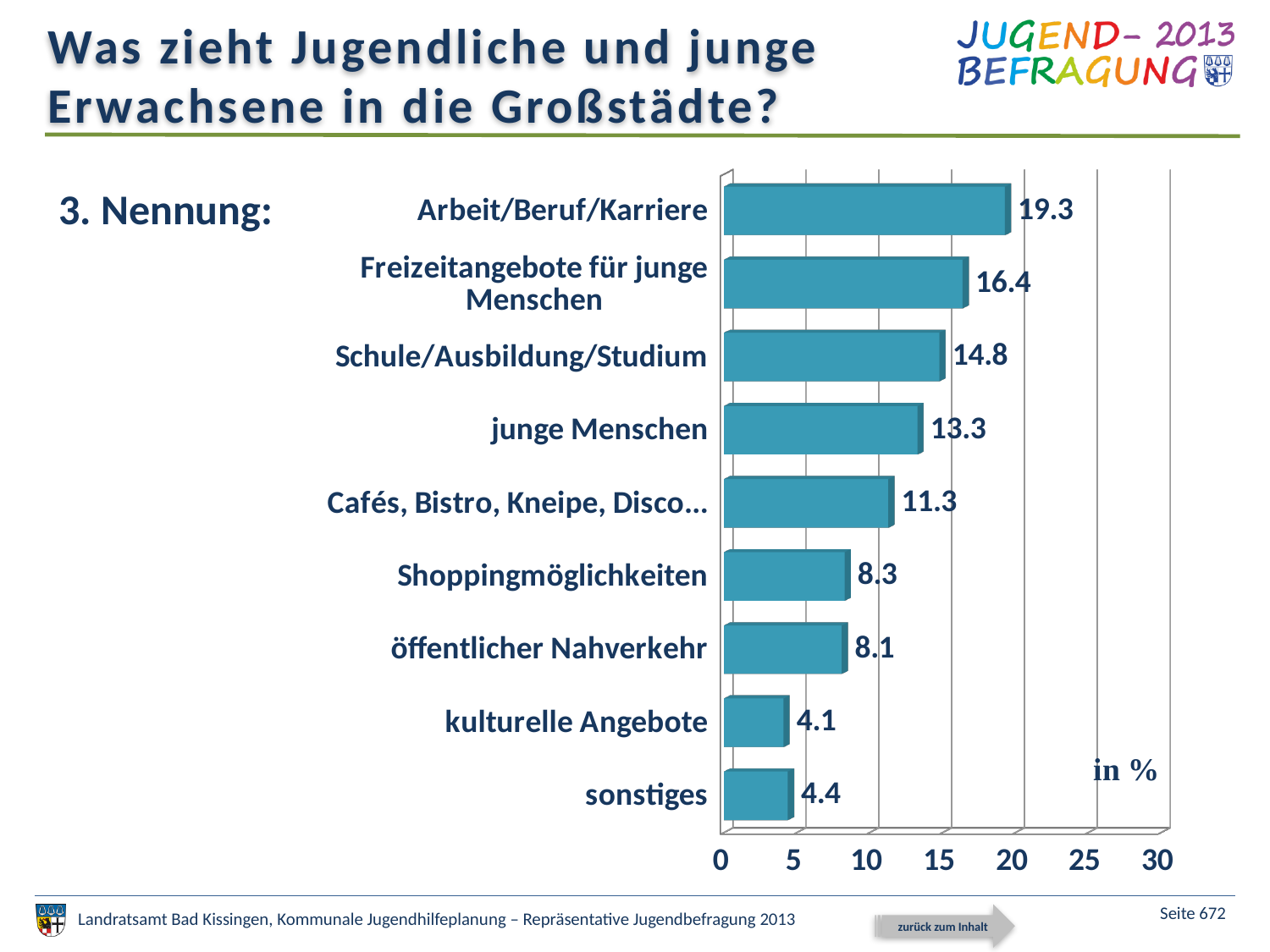
Which category has the highest value? Arbeit/Beruf/Karriere Is the value for junge Menschen greater or less than 10? greater Which is larger, the value for Shoppingmöglichkeiten or the value for Cafés, Bistro, Kneipe, Disco...? Cafés, Bistro, Kneipe, Disco... What is the difference between the values for sonstiges and kulturelle Angebote? 0.3 What is the difference between the values for Arbeit/Beruf/Karriere and Freizeitangebote für junge Menschen? 2.9 What is the value for öffentlicher Nahverkehr? 8.1 What is the value for Arbeit/Beruf/Karriere? 19.3 What is the value for Schule/Ausbildung/Studium? 14.8 Which category has the lowest value? kulturelle Angebote What unit is indicated for the values in the chart? in % What kind of chart is shown on the slide? bar chart How many categories are shown in the chart? 9